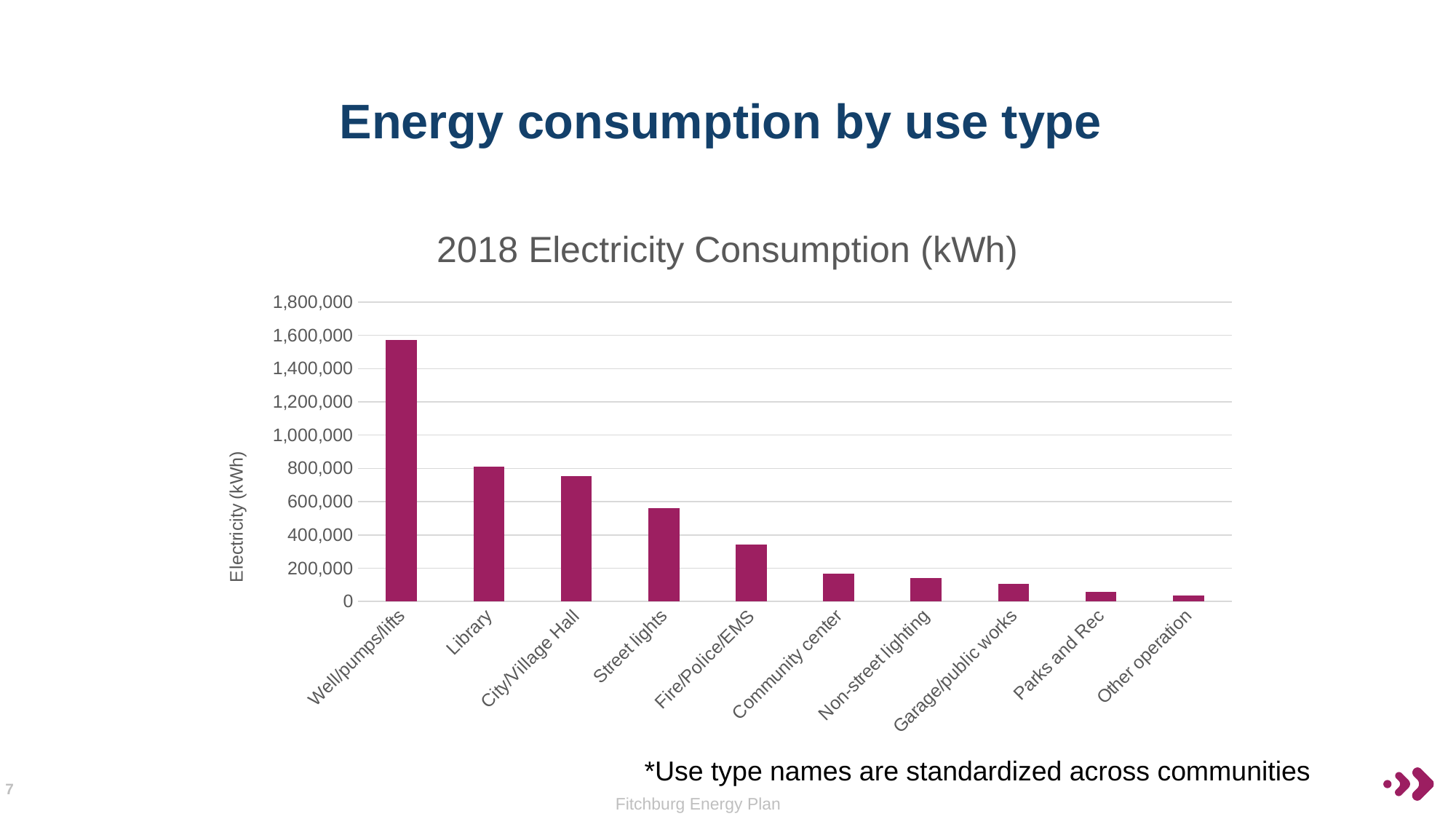
Do the values rise or fall moving from left to right along the x axis? Fall Which use type has the lowest 2018 electricity consumption? Other operation What kind of chart is shown on the slide? Bar chart How many use type categories are plotted in the chart? 10 Is the value for Fire/Police/EMS greater or less than 400,000? less Which use type has the highest 2018 electricity consumption? Well/pumps/lifts Is the value for Well/pumps/lifts greater or less than 1,400,000? greater What is the label on the vertical axis of the chart? Electricity (kWh) Is the value for Library greater or less than 1,000,000? less Which has the larger electricity consumption, Library or City/Village Hall? Library What is the title of the chart? 2018 Electricity Consumption (kWh)